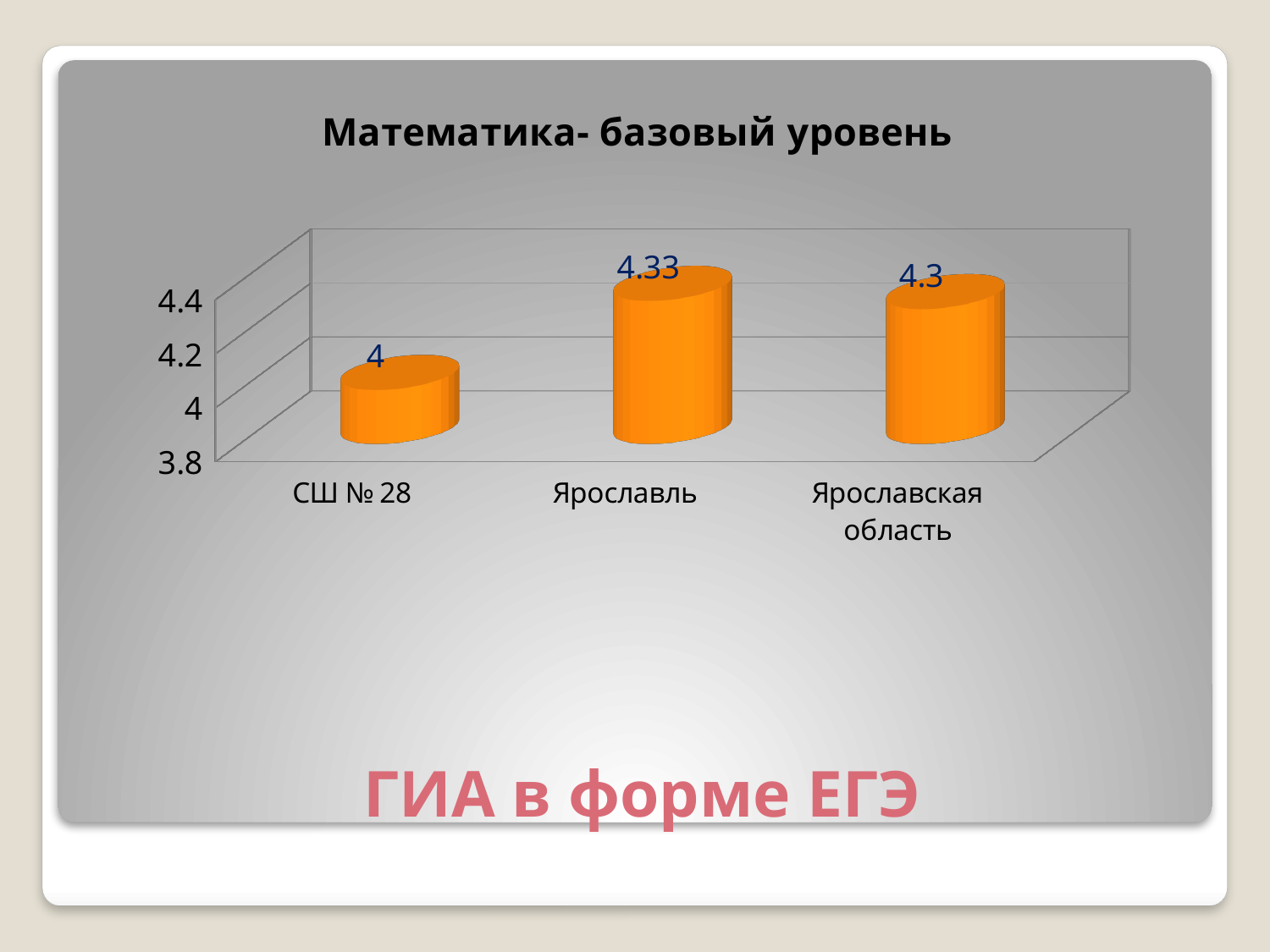
Which category has the lowest value? СШ № 28 What is the value for СШ № 28? 4 What is the title of the chart? Математика- базовый уровень What kind of chart is shown on the slide? bar chart Is the value for СШ № 28 greater or less than 4.2? less What is the difference between the values for Ярославская область and СШ № 28? 0.3 What is the difference between the values for Ярославль and СШ № 28? 0.33 What is the value for Ярославская область? 4.3 What is the value for Ярославль? 4.33 Which category has the highest value? Ярославль How many categories are shown on the chart? 3 Which is larger, the value for Ярославль or the value for Ярославская область? Ярославль